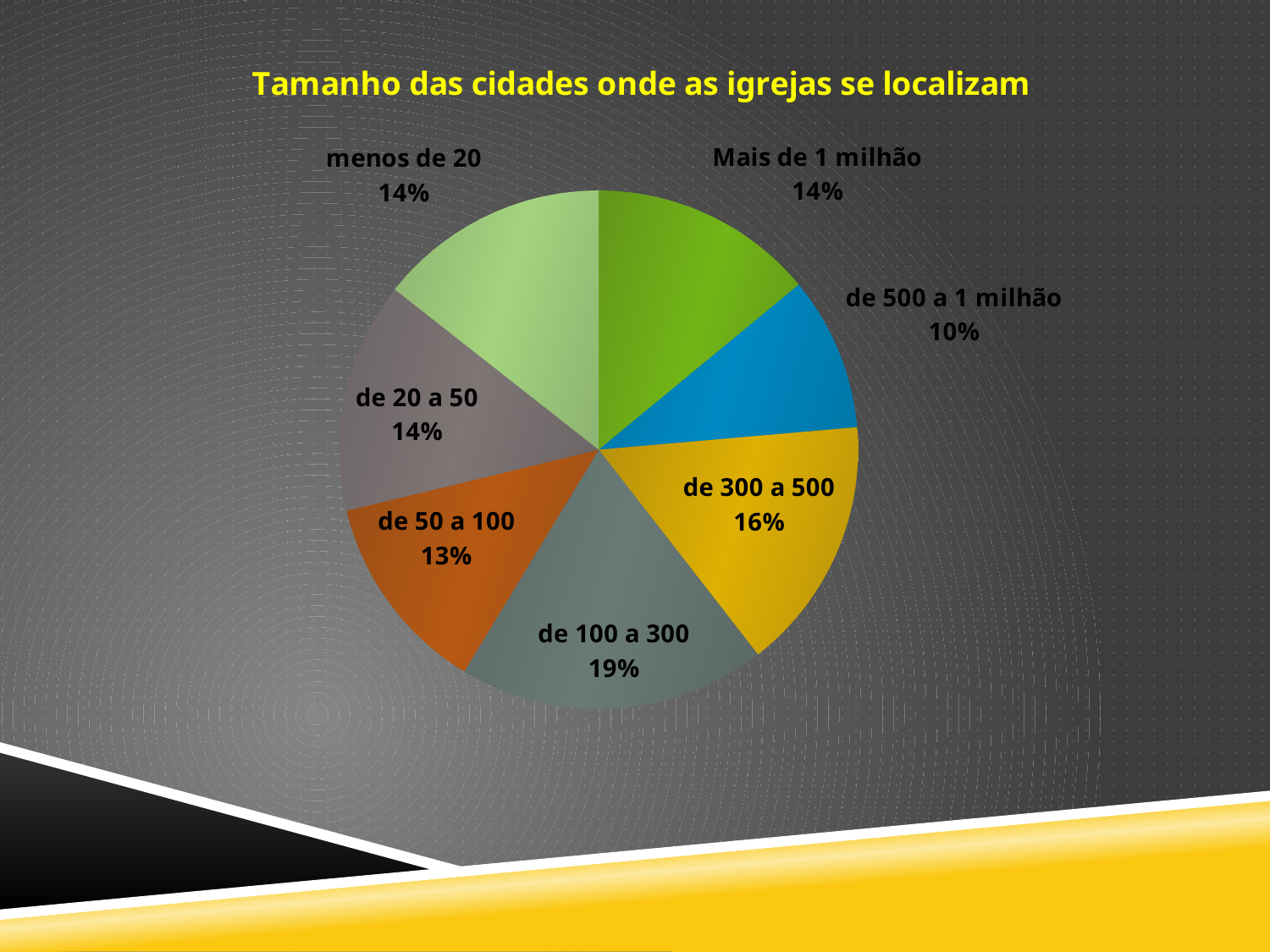
Which is larger, the share for 'de 300 a 500' or the share for 'de 50 a 100'? de 300 a 500 What is the title of the chart? Tamanho das cidades onde as igrejas se localizam What share of the pie is 'de 500 a 1 milhão'? 10% Which category has the smallest share of the pie? de 500 a 1 milhão What kind of chart is shown on the slide? pie chart How many slices does the pie chart have? 7 What is the value shown for 'Mais de 1 milhão'? 14% Which category has the largest share of the pie? de 100 a 300 What is the value shown for 'de 300 a 500'? 16% What share of the pie is 'de 100 a 300'? 19% What is the value shown for 'de 50 a 100'? 13% What is the difference between the shares of 'de 100 a 300' and 'de 500 a 1 milhão'? 9%